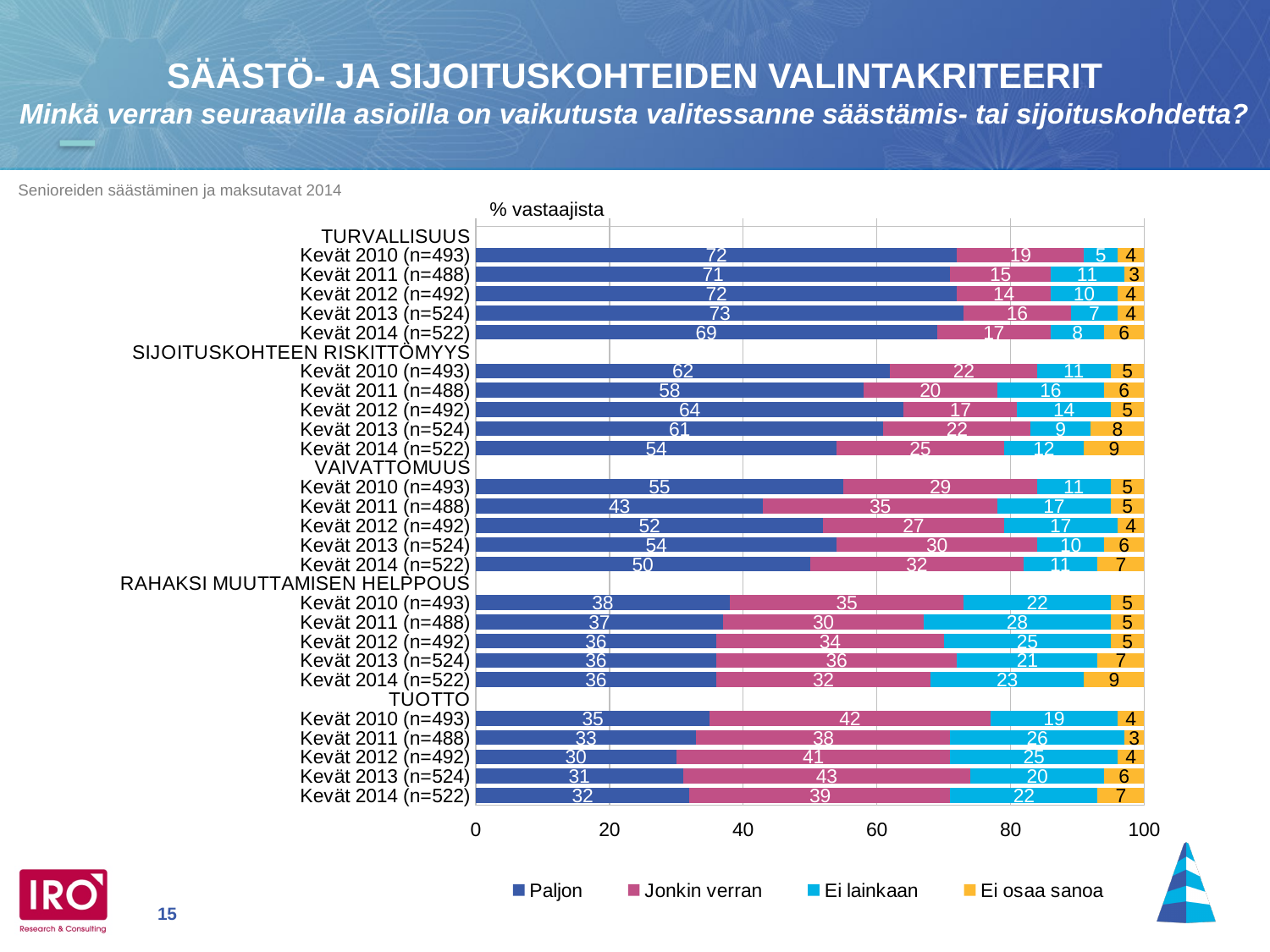
What is the label on the x axis of the chart? % vastaajista What is the difference between the 'Paljon' value for TURVALLISUUS Kevät 2010 and the 'Paljon' value for TUOTTO Kevät 2010? 37 What is the 'Ei lainkaan' value for RAHAKSI MUUTTAMISEN HELPPOUS, Kevät 2011 (n=488)? 28 What is the 'Ei osaa sanoa' value for SIJOITUSKOHTEEN RISKITTÖMYYS, Kevät 2014 (n=522)? 9 How many series does the legend list? 4 What is the total of the stacked bar for TURVALLISUUS, Kevät 2014 (n=522)? 100 What is the 'Jonkin verran' value for TUOTTO, Kevät 2013 (n=524)? 43 Which is larger: the 'Jonkin verran' value for VAIVATTOMUUS Kevät 2011 or for VAIVATTOMUUS Kevät 2012? VAIVATTOMUUS Kevät 2011 Which row has the highest 'Paljon' value? TURVALLISUUS, Kevät 2013 (n=524) What kind of chart is shown on the slide? bar chart What is the 'Paljon' value for TURVALLISUUS, Kevät 2010 (n=493)? 72 Which row has the lowest 'Paljon' value? TUOTTO, Kevät 2012 (n=492)